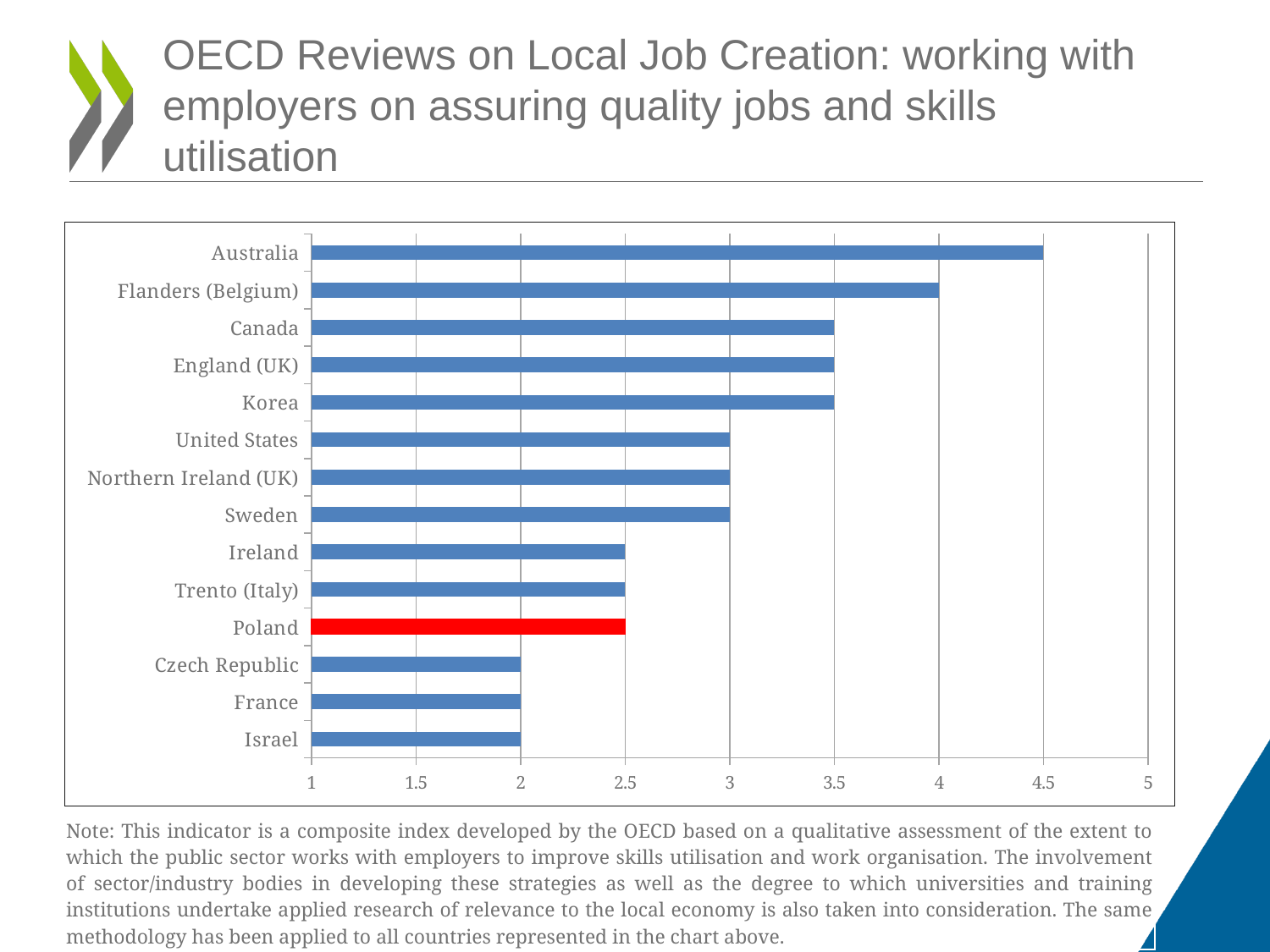
What is the value for Poland? 2.5 Which country's bar is coloured red in the chart? Poland What is the value for Australia? 4.5 What is the difference between the values for Flanders (Belgium) and Israel? 2 What is the value for Korea? 3.5 Is the value for the United States greater or less than 2.5? greater What is the value for Flanders (Belgium)? 4 Which is larger, the value for Canada or the value for Sweden? Canada How many countries or regions are shown in the chart? 14 What is the difference between the values for Australia and Poland? 2 Which country has the highest value in the chart? Australia What type of chart is shown on the slide? Bar chart